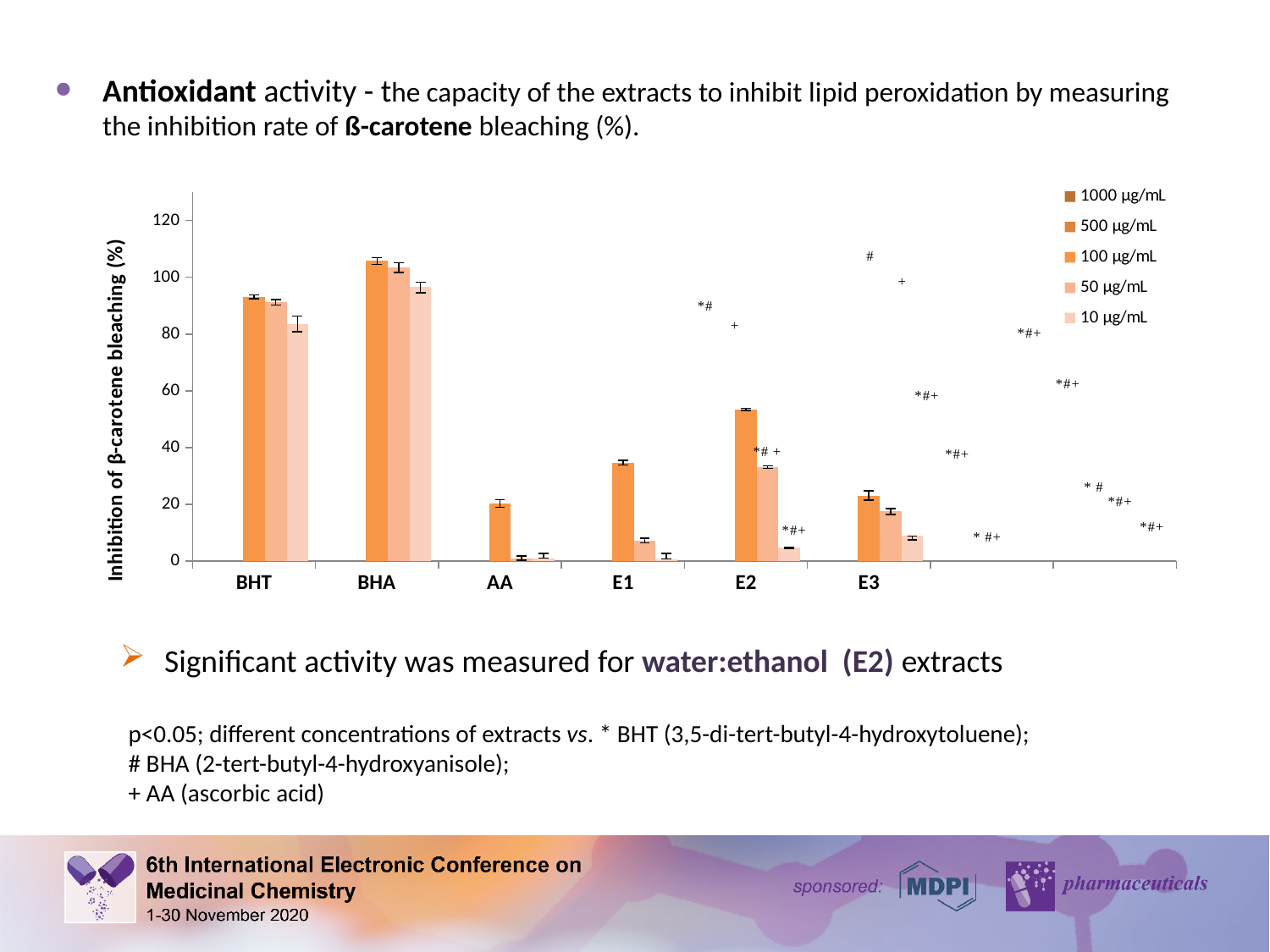
Is the value of the 100 µg/mL bar for BHT greater or less than 80? greater Is the value of the 100 µg/mL bar for E2 greater or less than 40? greater How many series does the chart's legend list? 5 What kind of chart is shown on the slide? bar chart Is the value of the 100 µg/mL bar for BHA greater or less than 100? greater Which has the larger 100 µg/mL value, E1 or E2? E2 Which has the larger 100 µg/mL value, BHA or E2? BHA How many categories are shown along the x axis of the chart? 6 What is the title of the chart's y axis? Inhibition of β-carotene bleaching (%) Which category has the highest bars in the chart? BHA